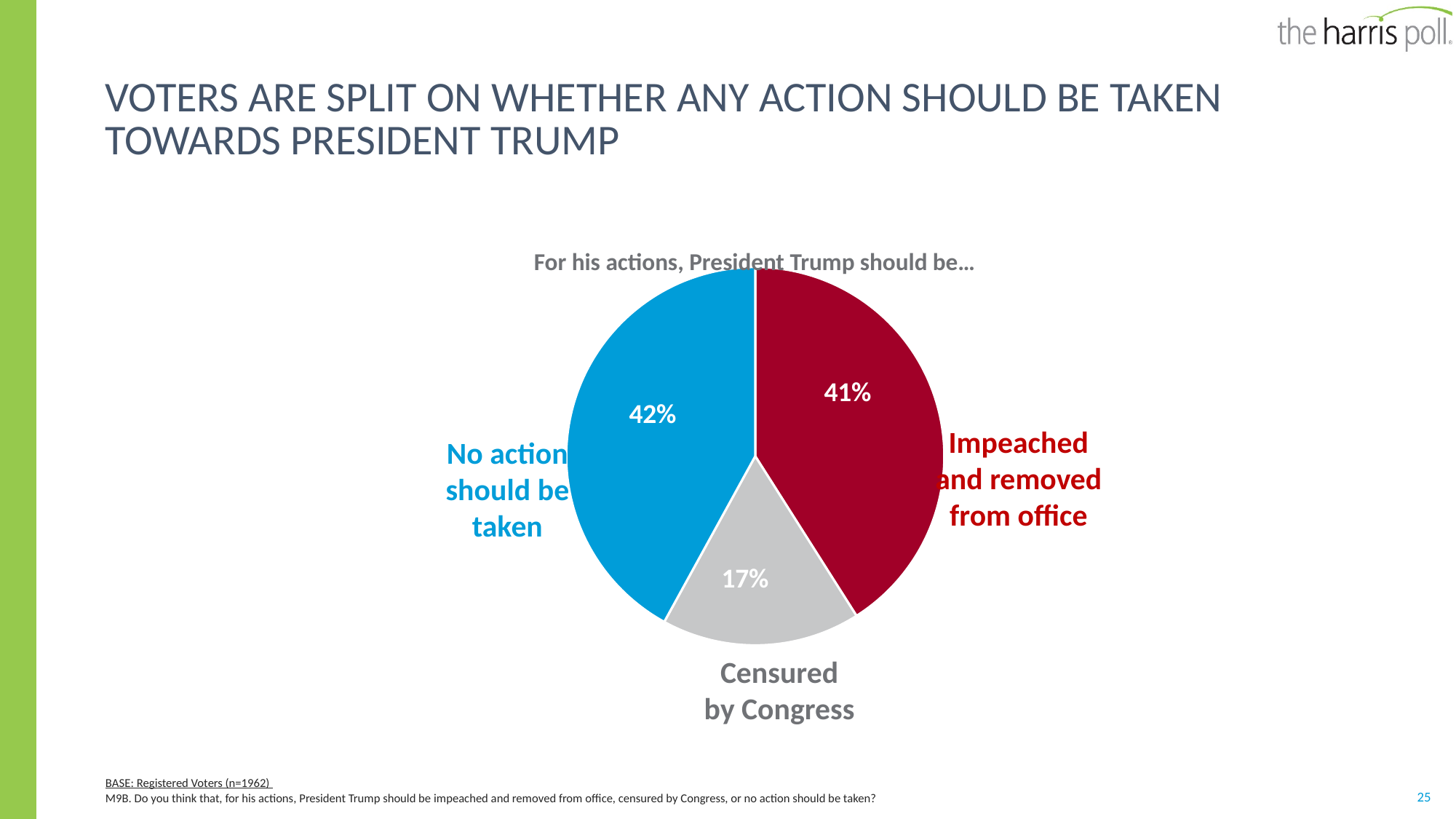
What colour is the slice for 'Censured by Congress'? grey What is the difference in percentage points between 'Impeached and removed from office' and 'Censured by Congress'? 24 What percentage of registered voters say President Trump should be impeached and removed from office? 41% What percentage of registered voters say President Trump should be censured by Congress? 17% What percentage of registered voters say no action should be taken? 42% Which response has the largest share of the pie? No action should be taken How many slices does the pie chart have? 3 What is the title of the pie chart? For his actions, President Trump should be… Which is larger: the share for 'Impeached and removed from office' or the share for 'Censured by Congress'? Impeached and removed from office What type of chart is shown on the slide? pie chart What is the difference in percentage points between 'No action should be taken' and 'Censured by Congress'? 25 Which response has the smallest share of the pie? Censured by Congress